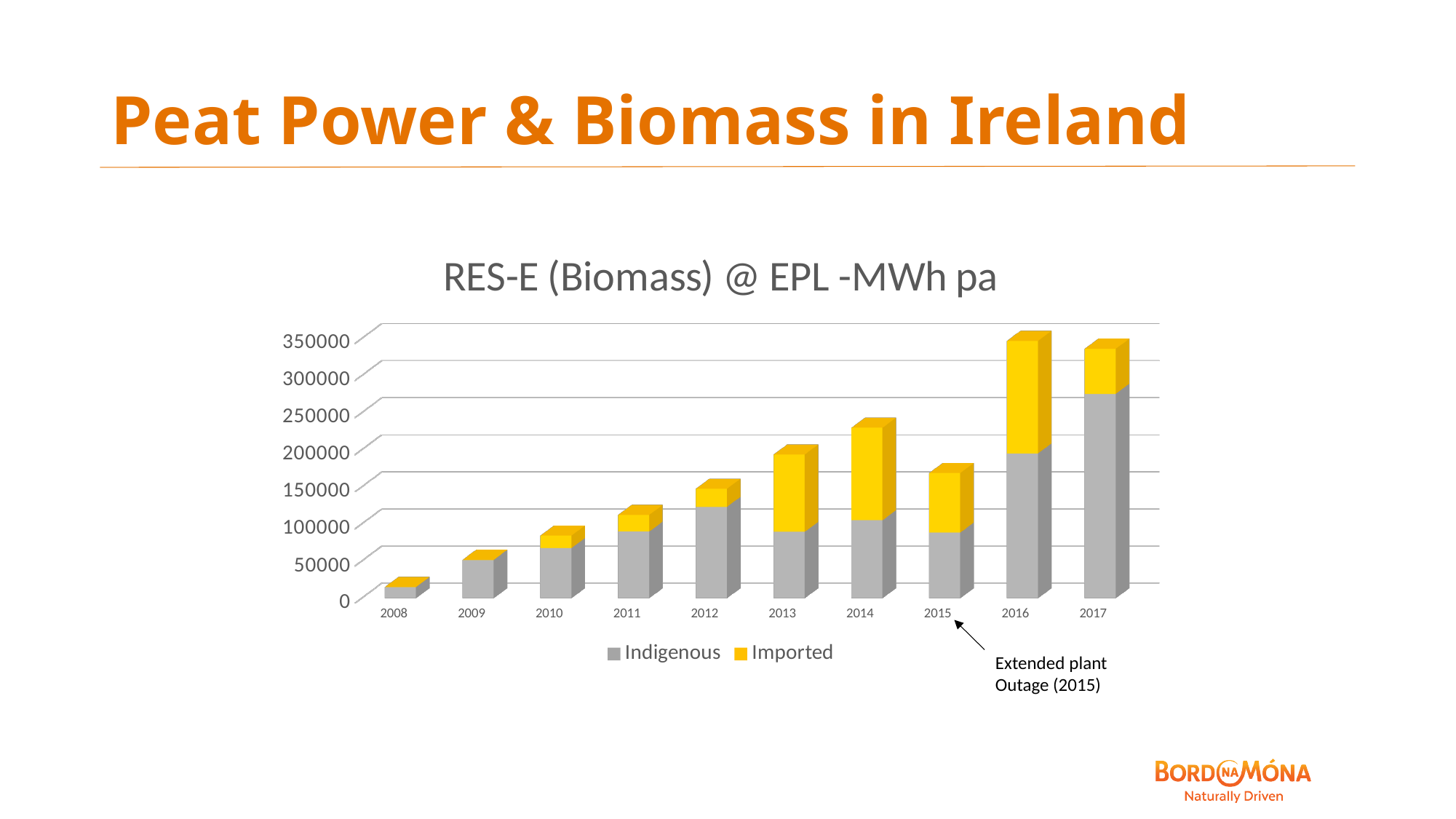
Which year has the larger total bar, 2014 or 2015? 2014 What kind of chart is shown on the slide? Stacked bar chart Is the total value for 2008 greater or less than 50000? less How many years are shown on the x axis of the chart? 10 Which year has the highest total bar? 2016 Do the total values rise or fall from 2008 to 2014? Rise What event does the annotation near the 2015 bar refer to? Extended plant Outage (2015) What is the title of the chart? RES-E (Biomass) @ EPL -MWh pa Is the total value for 2016 greater or less than 300000? greater Is the total value for 2015 greater or less than 200000? less How many series does the legend list? 2 Which year has the lowest total bar? 2008